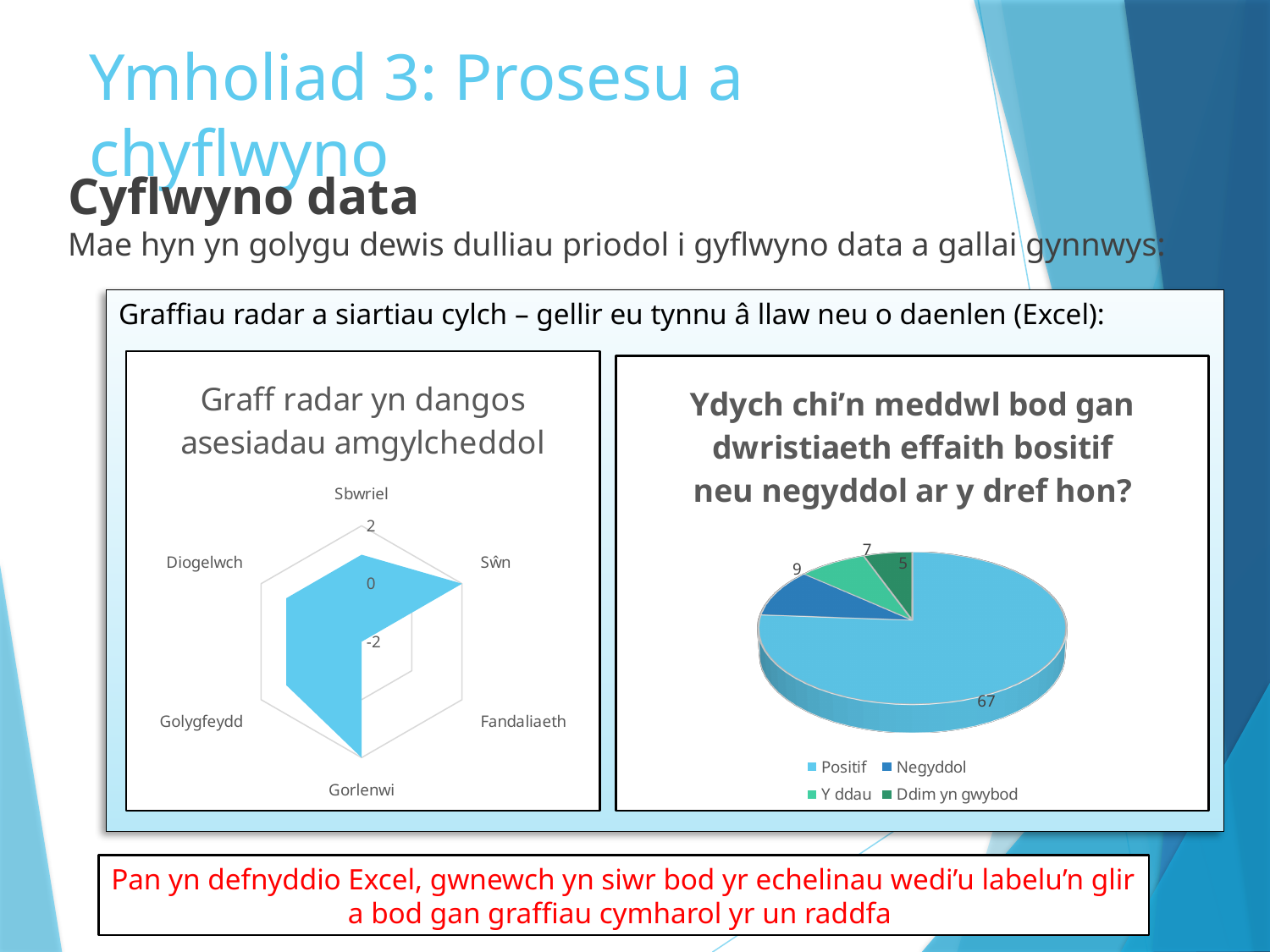
In the pie chart on the right, what is the value for Y ddau? 7 In the pie chart on the right, what is the value for Ddim yn gwybod? 5 What is the title of the radar chart on the left? Graff radar yn dangos asesiadau amgylcheddol In the pie chart on the right, what is the difference between the values for Positif and Negyddol? 58 In the pie chart on the right, what is the value for Negyddol? 9 What kind of chart is the chart on the right of the slide? pie chart In the pie chart on the right, which category has the smallest slice? Ddim yn gwybod In the pie chart on the right, which category has the largest slice? Positif In the pie chart on the right, what is the value for Positif? 67 How many entries does the legend of the pie chart on the right list? 4 How many categories does the radar chart on the left have? 6 What kind of chart is the chart on the left of the slide? radar chart